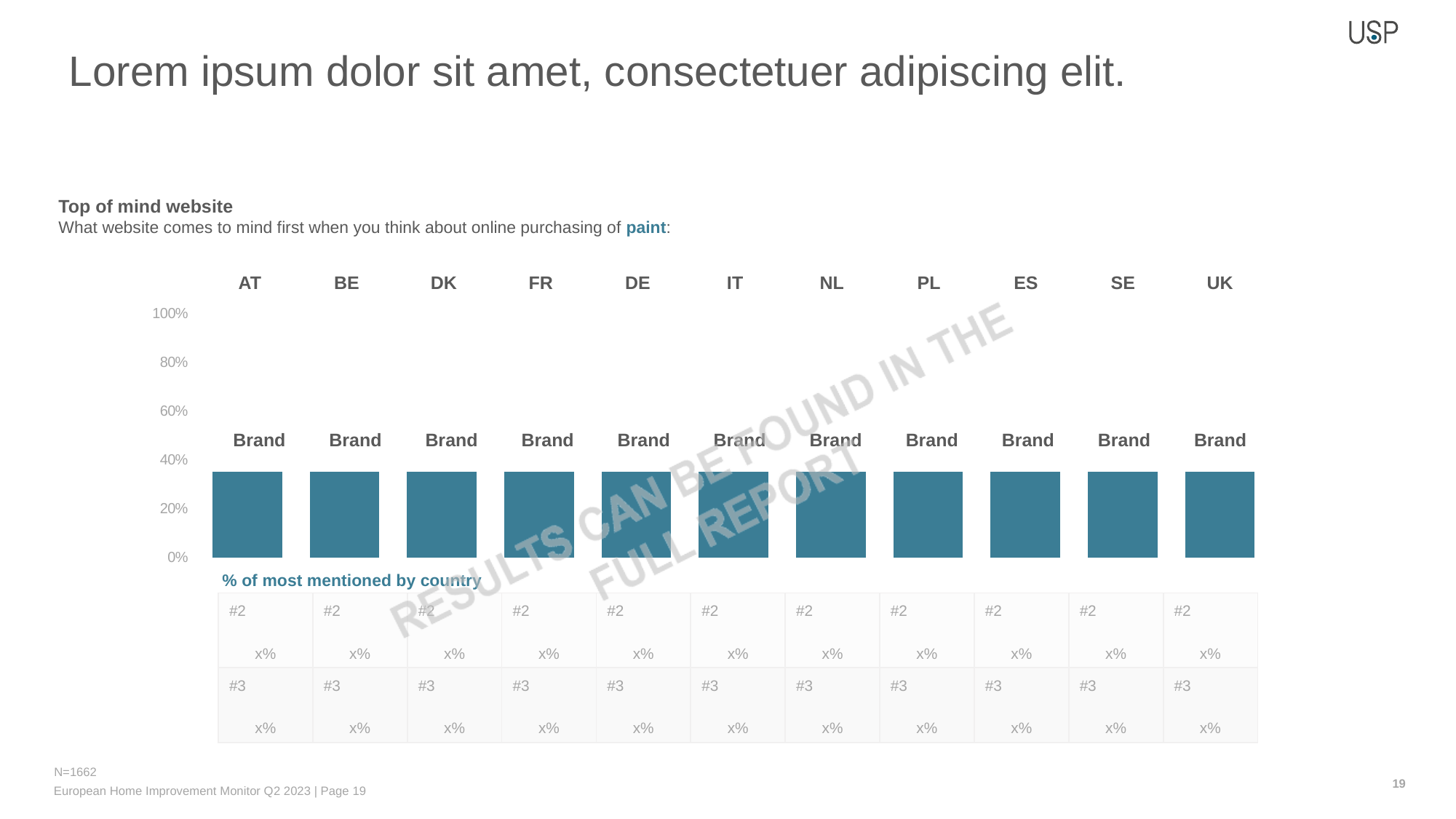
Is the value for DE greater or less than 60%? less Is the value for UK greater or less than 20%? greater How many countries are shown along the x axis of the chart? 11 What is the highest value shown on the y axis of the chart? 100% Is the value for FR greater or less than 80%? less Which country label appears first (leftmost) on the x axis? AT What is the title of the chart? Top of mind website What kind of chart is shown on the slide? bar chart